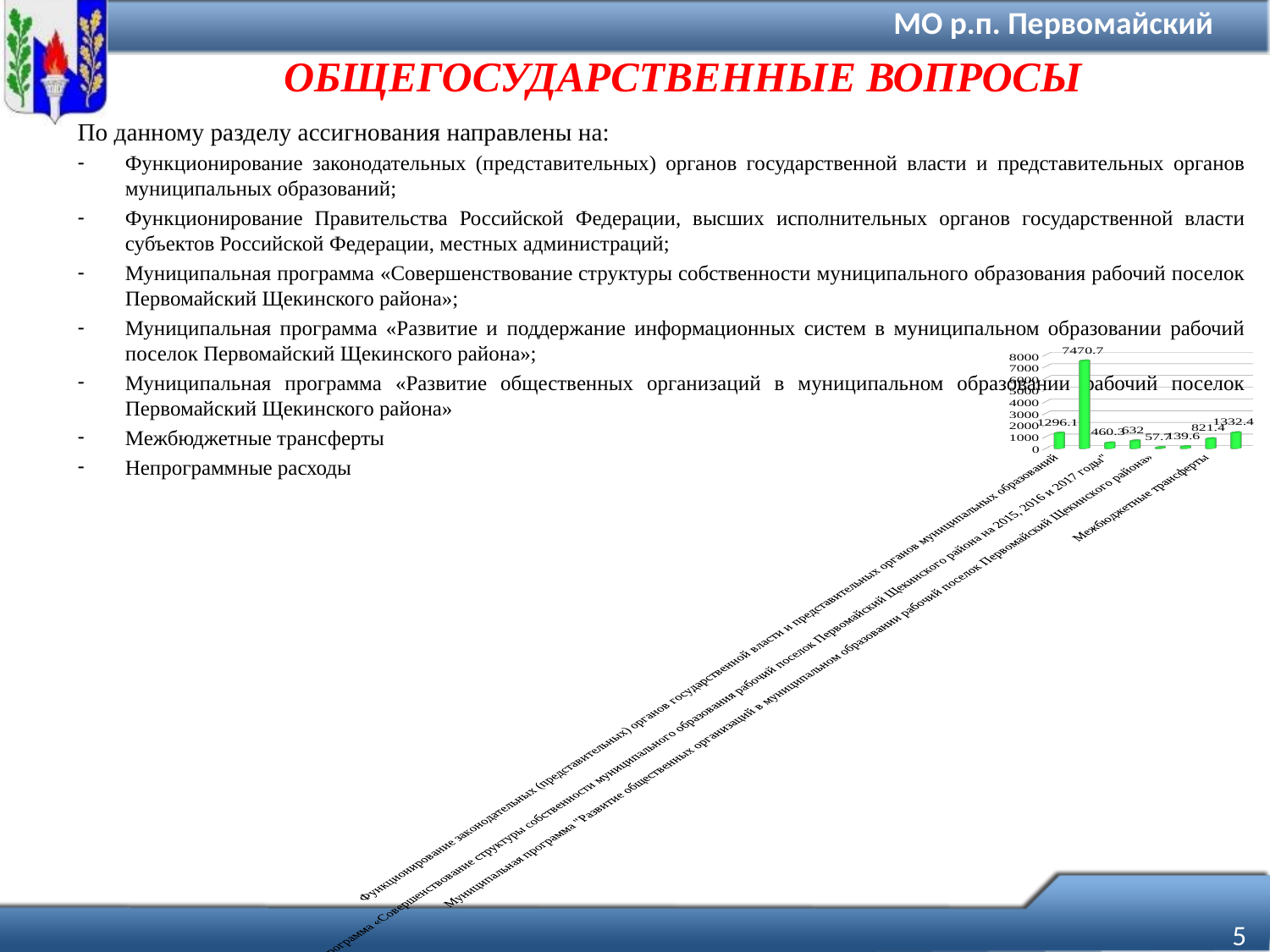
What is the highest value labelled on the chart? 7470.7 What is the value of the rightmost bar in the chart? 1332.4 What is the value of the leftmost bar in the chart? 1296.1 What colour are the bars in the chart? green How many bars are plotted in the chart? 8 Which is larger, the leftmost bar (1296.1) or the rightmost bar (1332.4)? the rightmost bar (1332.4) What is the lowest value labelled on the chart? 57.7 What is the difference between the highest value (7470.7) and the lowest value (57.7) on the chart? 7413 What is the difference between the rightmost bar (1332.4) and the leftmost bar (1296.1)? 36.3 Is the tallest bar in the chart greater or less than 7000? greater What is the highest tick value shown on the vertical axis of the chart? 8000 What kind of chart is shown on the slide? bar chart